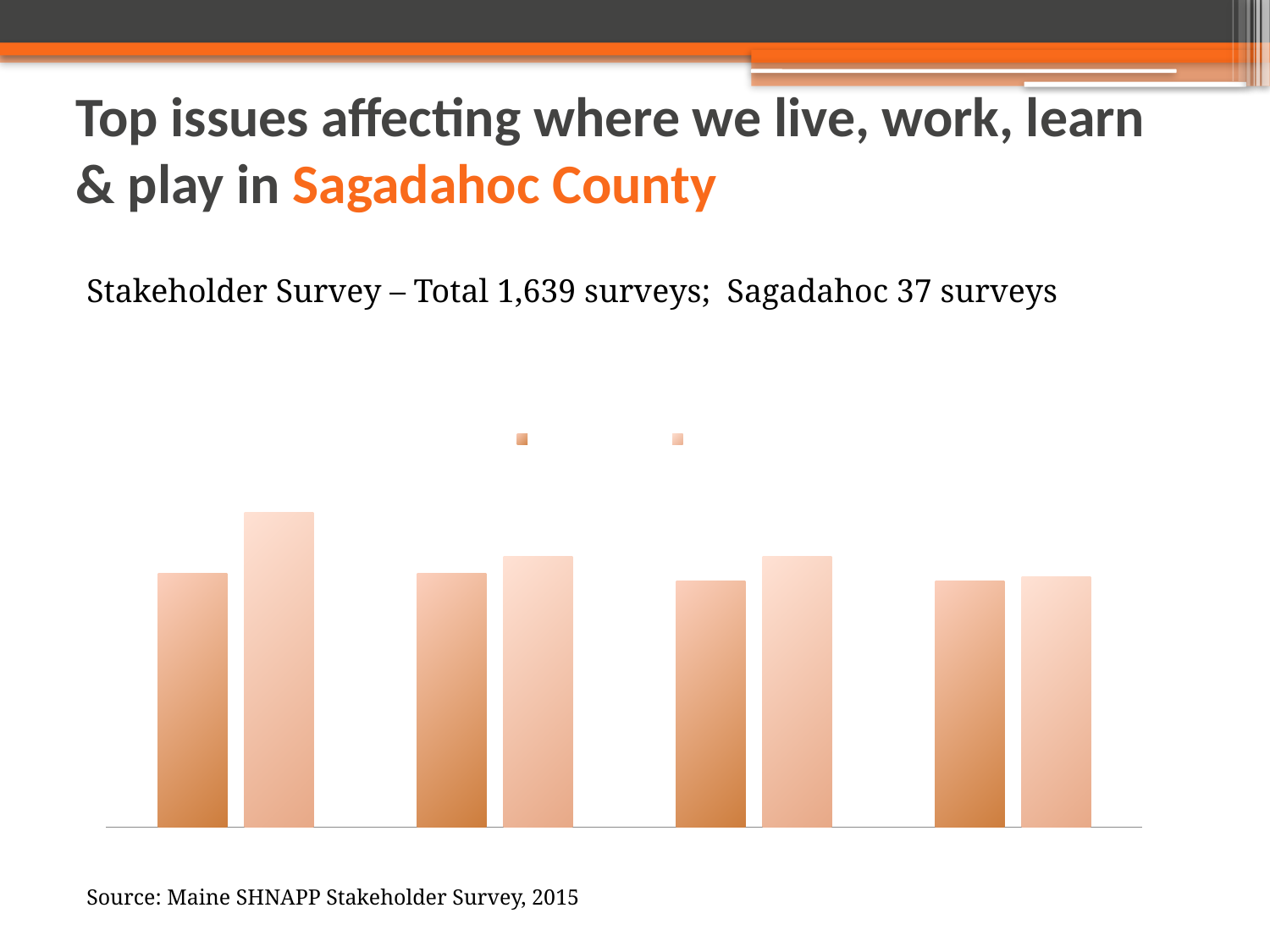
How many groups of bars does the chart show? 4 Which group of bars contains the tallest bar on the chart? the leftmost group What kind of chart is shown on the slide? bar chart How many bars are plotted on the chart in total? 8 What source is cited below the chart? Maine SHNAPP Stakeholder Survey, 2015 In the second group of bars from the left, which bar is taller, the left (darker) bar or the right (lighter) bar? the right (lighter) bar In the third group of bars from the left, which bar is taller, the left (darker) bar or the right (lighter) bar? the right (lighter) bar According to the slide, how many surveys were completed for Sagadahoc? 37 surveys In the leftmost group of bars, which bar is taller, the left (darker) bar or the right (lighter) bar? the right (lighter) bar How many series does the chart's legend list? 2